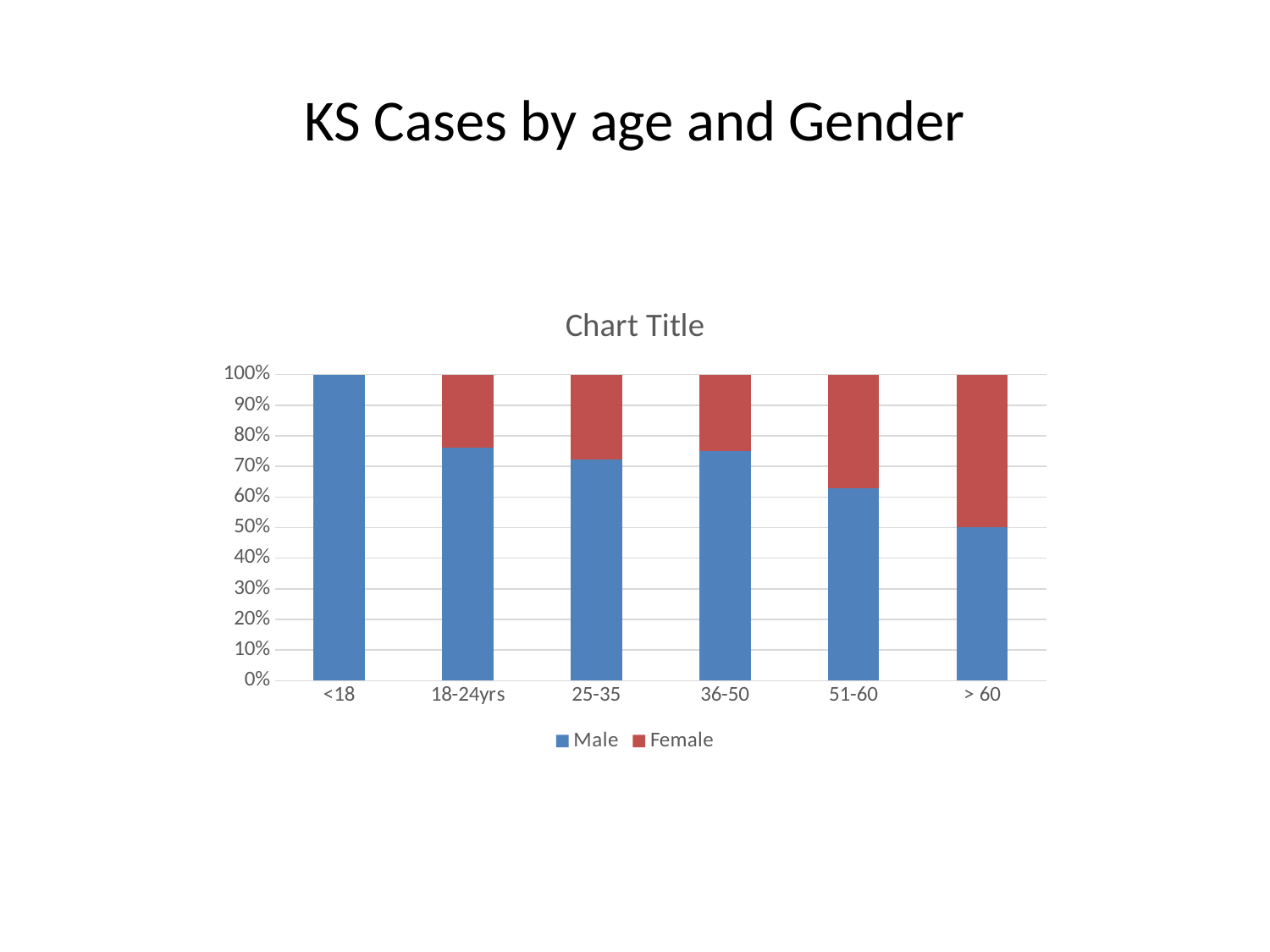
What kind of chart is shown on the slide? Stacked bar chart What is the Male share for the <18 age group? 100% How many series does the legend list? 2 Which age group has the lowest Male share? > 60 Which colour represents the Female series in the chart? Red What is the Male share for the > 60 age group? 50% Is the Male share for 51-60 greater or less than 70%? less Which age group has the largest Female share? > 60 Is the Male share for 18-24yrs greater or less than 70%? greater Which is larger, the Male share for 18-24yrs or for 51-60? 18-24yrs How many age categories are shown on the x axis? 6 Which age group has the highest Male share? <18